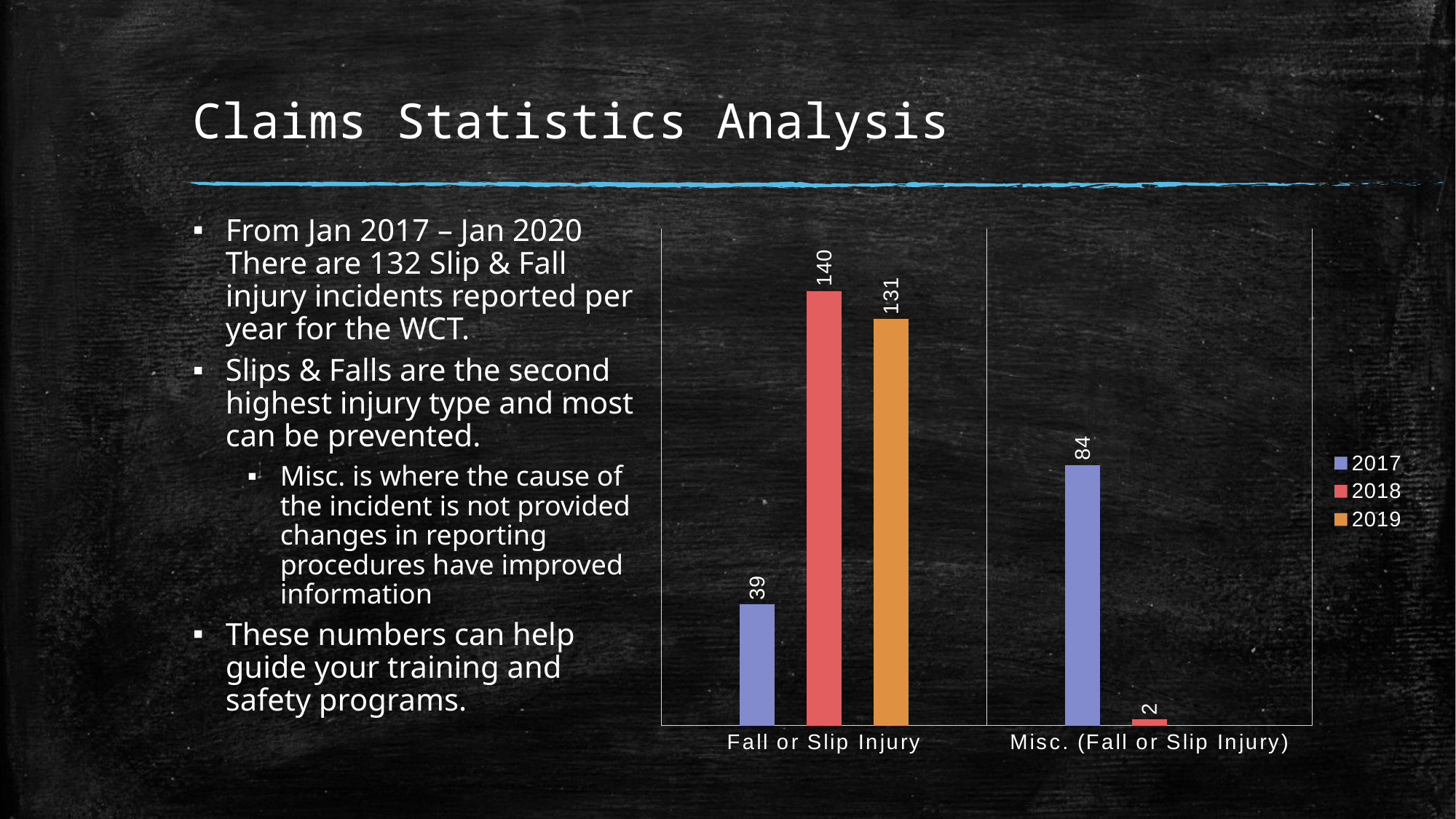
What is the value for 2018 in the Misc. (Fall or Slip Injury) category? 2 What is the difference between the 2017 and 2018 values in the Misc. (Fall or Slip Injury) category? 82 How many series does the legend list? 3 What is the value for 2019 in the Fall or Slip Injury category? 131 Which year has the lowest value in the Fall or Slip Injury category? 2017 Which year has the highest value in the Fall or Slip Injury category? 2018 What is the value for 2017 in the Fall or Slip Injury category? 39 For 2017, which category has the larger value: Fall or Slip Injury or Misc. (Fall or Slip Injury)? Misc. (Fall or Slip Injury) What is the value for 2018 in the Fall or Slip Injury category? 140 What is the value for 2017 in the Misc. (Fall or Slip Injury) category? 84 What is the difference between the 2018 and 2019 values in the Fall or Slip Injury category? 9 What kind of chart is shown on the slide? Bar chart